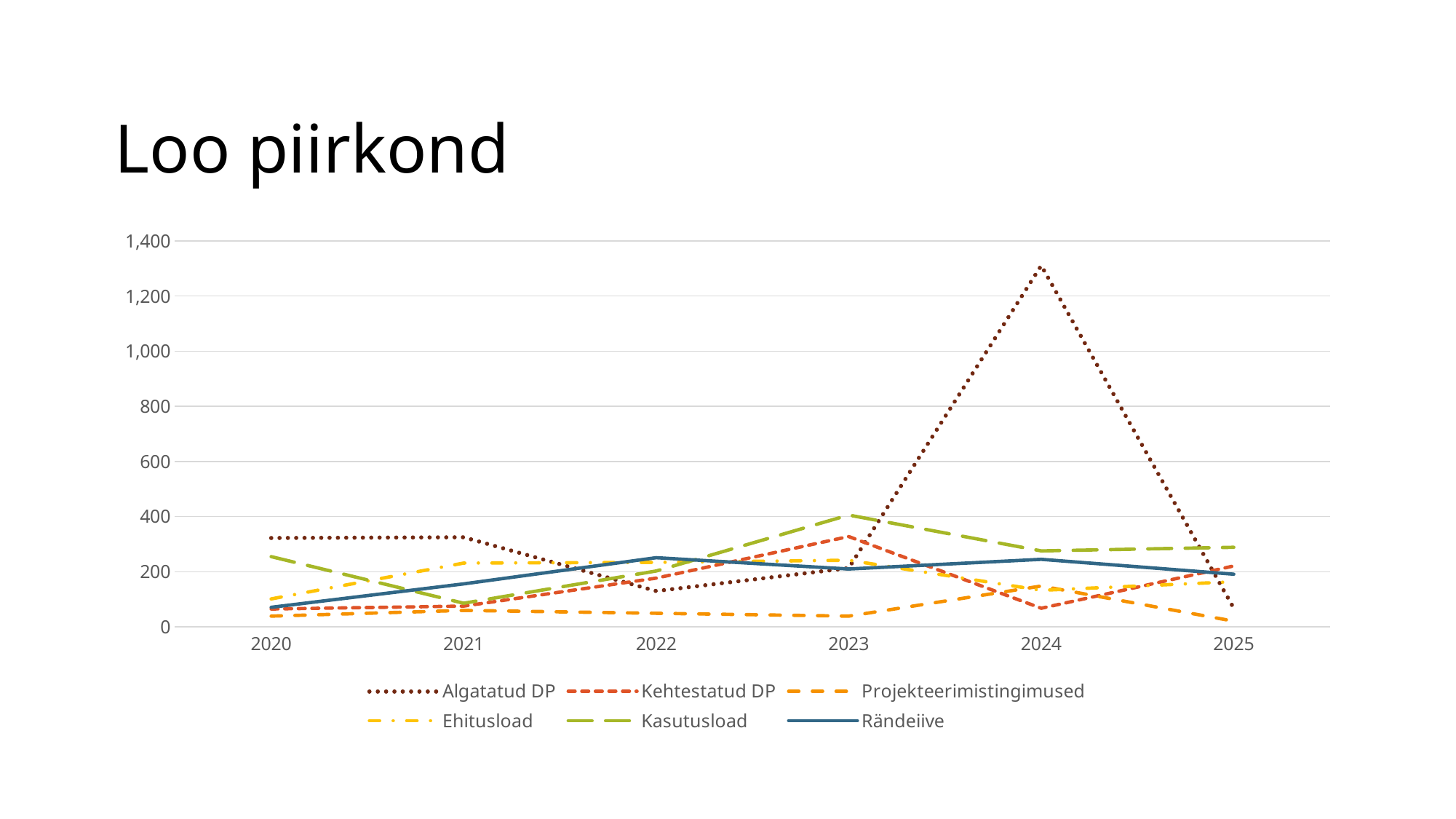
Is the value for Algatatud DP in 2024 greater or less than 1,200? greater What kind of chart is shown on the slide? line chart Does the Projekteerimistingimused series rise or fall from 2024 to 2025? fall How many series does the legend list? 6 What is the title of the slide containing the chart? Loo piirkond In which year does the Algatatud DP series have its lowest value? 2025 Is the value for Projekteerimistingimused in 2025 greater or less than 200? less In which year does the Algatatud DP series reach its highest value? 2024 In 2024, which is larger: Algatatud DP or Kasutusload? Algatatud DP How many years are shown on the x axis? 6 Is the value for Kasutusload in 2023 greater or less than 200? greater Which series has the highest value in 2023? Kasutusload